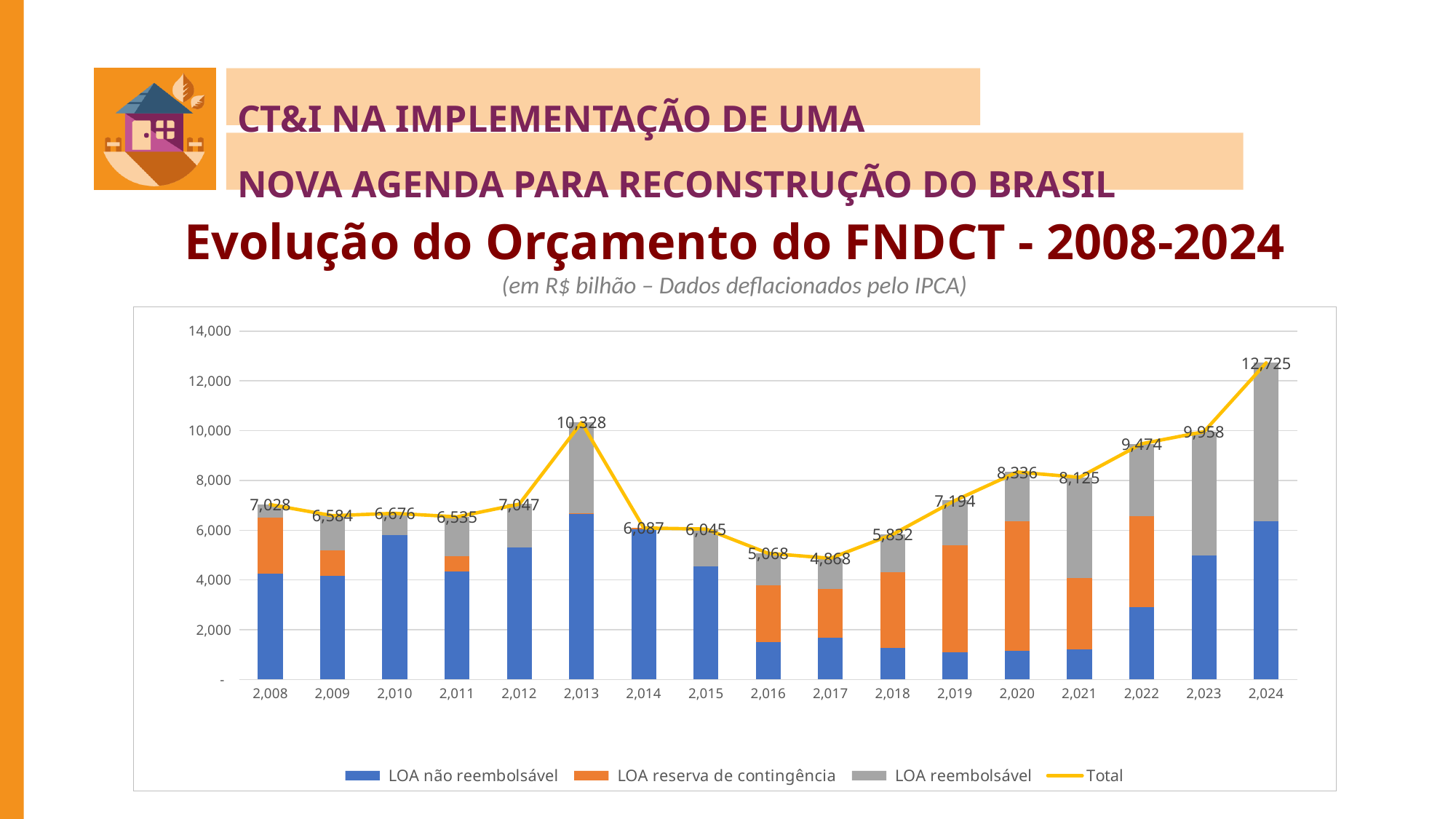
What is the Total value for 2,024? 12,725 Is the value for LOA não reembolsável in 2,010 greater or less than 4,000? greater What is the difference between the Total for 2,024 and the Total for 2,023? 2,767 Which year has the highest Total? 2,024 Which year has the lowest Total? 2,017 How many years are shown on the x axis? 17 What is the Total value for 2,013? 10,328 What is the Total value for 2,017? 4,868 Which year has a larger Total, 2,020 or 2,021? 2,020 What kind of chart is shown on the slide? Stacked bar chart with a line How many series does the legend list? 4 Does the Total rise or fall from 2,021 to 2,024? rise